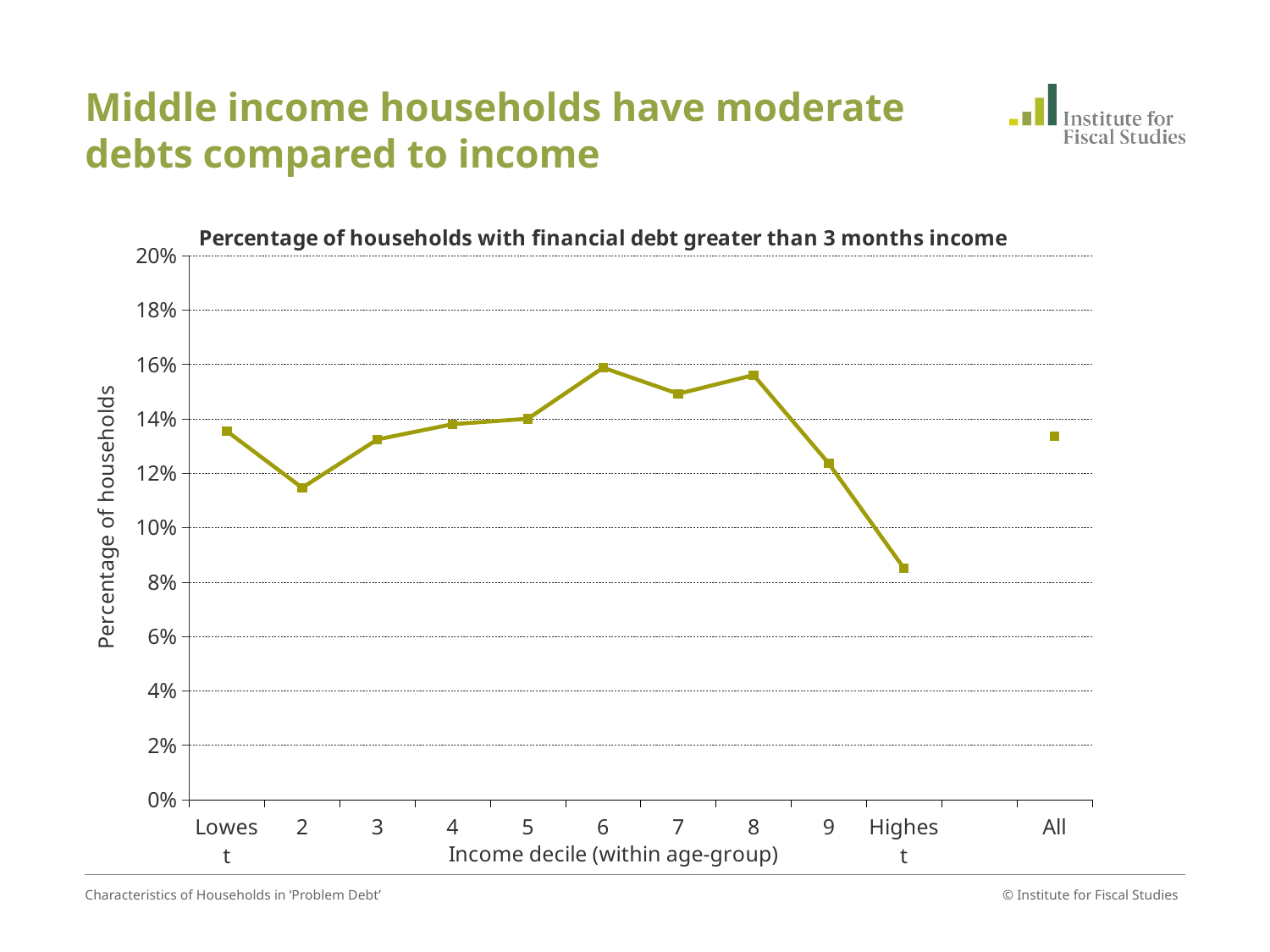
Which has a higher value, income decile 2 or income decile 7? 7 How many categories are shown along the x axis? 11 Which income decile has the lowest percentage of households with financial debt greater than 3 months income? Highest Is the value for income decile 2 greater or less than 12%? less Which has a higher percentage of households with financial debt greater than 3 months income, income decile 6 or the Highest income decile? 6 What is the label of the x axis? Income decile (within age-group) What kind of chart is shown on the slide? line chart Is the value for income decile 6 greater or less than 14%? greater What is the title of the chart? Percentage of households with financial debt greater than 3 months income Do the values rise or fall from income decile 8 to the Highest income decile? fall Is the value for the Highest income decile greater or less than 10%? less